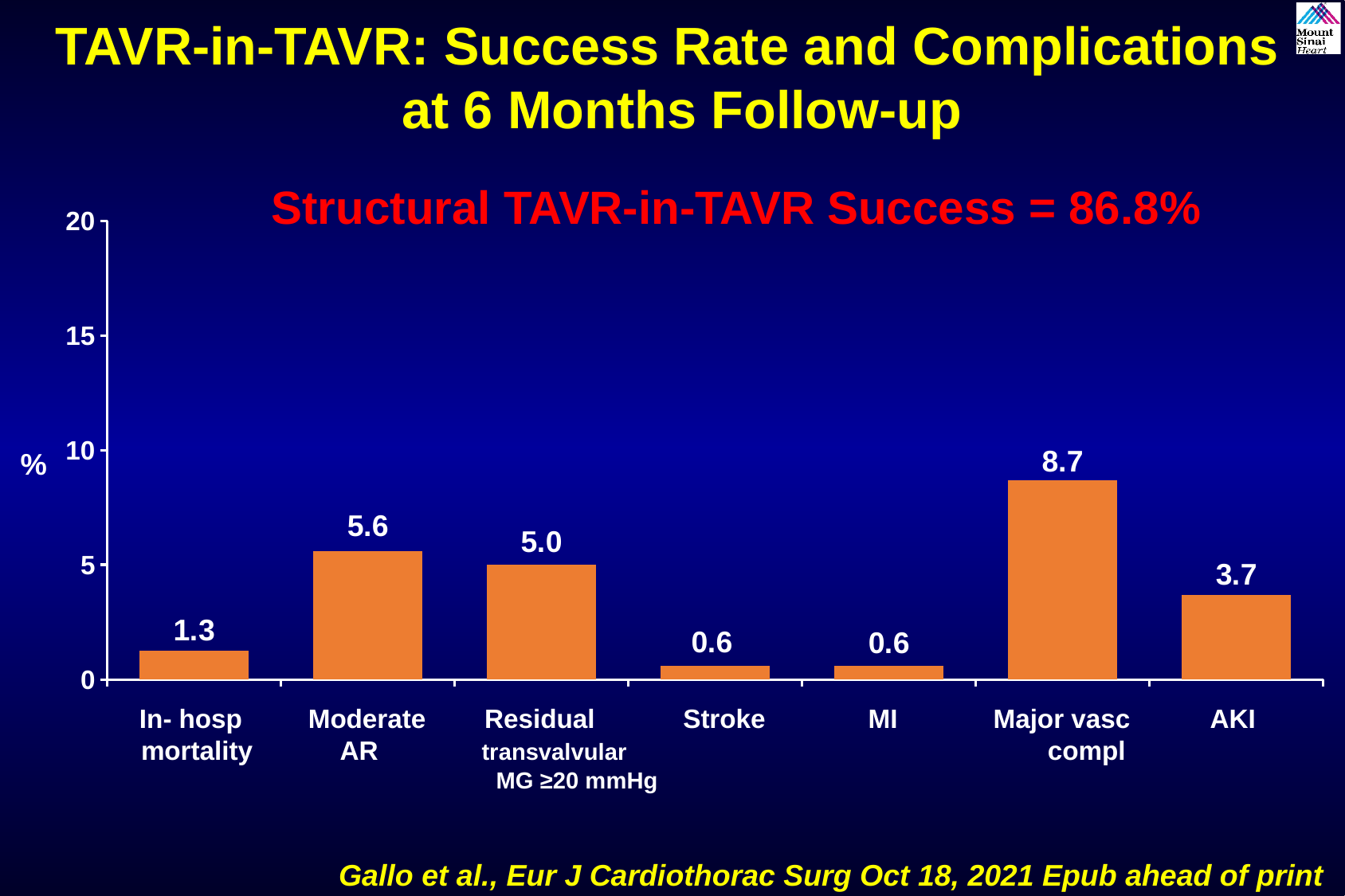
What is the value for Moderate AR? 5.6 What is the value for Major vasc compl? 8.7 Which category has the highest value? Major vasc compl What is the difference between the values for Major vasc compl and AKI? 5.0 What is the value for In- hosp mortality? 1.3 Which is larger, the value for Moderate AR or the value for AKI? Moderate AR What is the value for AKI? 3.7 What is the Structural TAVR-in-TAVR Success rate stated above the chart? 86.8% What is the difference between the values for Moderate AR and Residual transvalvular MG ≥20 mmHg? 0.6 How many categories are shown on the x axis? 7 Is the value for Major vasc compl greater or less than 10? less What kind of chart is shown on the slide? bar chart